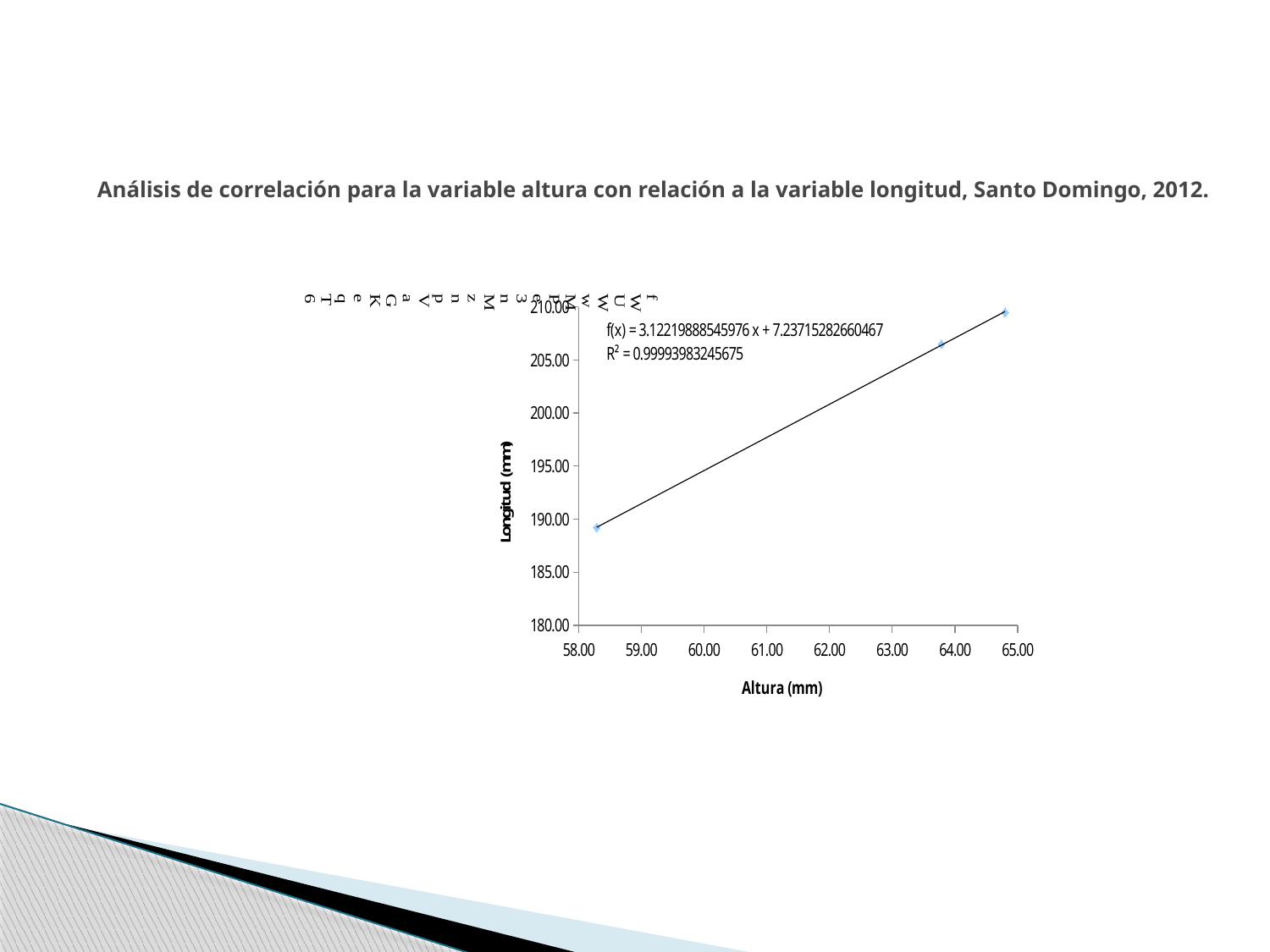
Is the Longitud value of the rightmost point (near Altura 65.00) greater or less than 205.00? greater Does Longitud rise or fall as Altura increases along the x axis? rise What kind of chart is shown on the slide? scatter chart Is the Longitud value of the middle point (near Altura 64.00) greater or less than 200.00? greater What is the title of the x axis? Altura (mm) Is the Altura value of the leftmost point greater or less than 59.00? less How many data points are plotted on the chart? 3 What is the title of the y axis? Longitud (mm) What is the R² value printed on the chart? 0.99993983245675 What is the trendline equation printed on the chart? f(x) = 3.12219888545976 x + 7.23715282660467